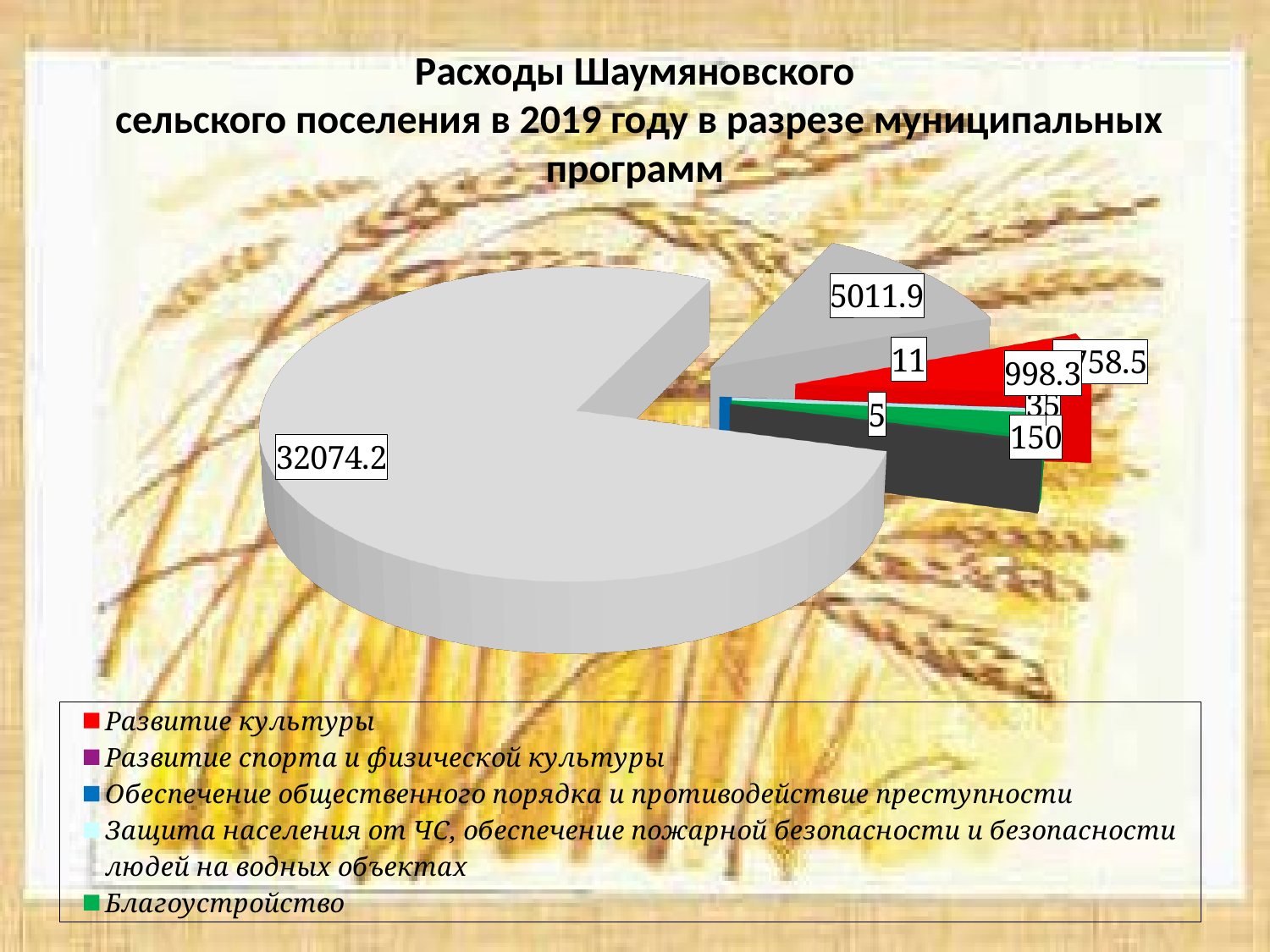
How many data labels are shown on the pie? 8 What is the smallest value labelled on the pie? 5 Which is larger, the slice labelled 758.5 or the slice labelled 150? 758.5 What value is shown on the largest slice of the pie? 32074.2 What colour does the legend use for Благоустройство? green What is the difference between the largest slice value (32074.2) and the second-largest slice value (5011.9)? 27062.3 How many entries does the legend list? 5 What value is shown on the second-largest slice of the pie? 5011.9 What kind of chart is shown on the slide? pie chart Which year does the chart title say the expenditures refer to? 2019